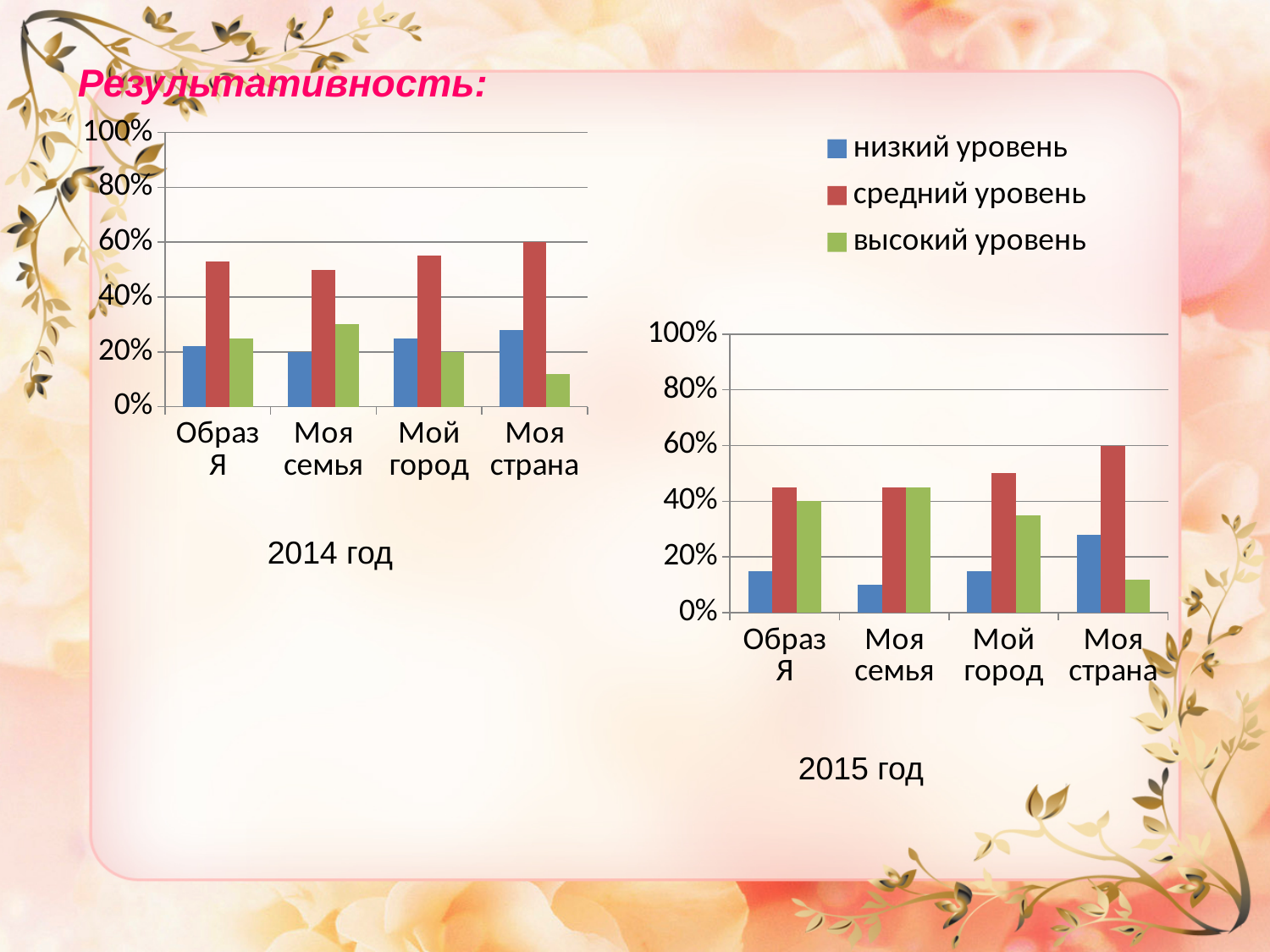
In the 2015 год chart, is the средний уровень value for Мой город greater or less than 40%? greater How many series does the legend list? 3 In the 2015 год chart, which category has the highest низкий уровень bar? Моя страна In the 2015 год chart, which is larger for Моя страна: the низкий уровень bar or the высокий уровень bar? низкий уровень In the 2014 год chart, is the средний уровень value for Образ Я greater or less than 40%? greater In the 2014 год chart, which category has the highest средний уровень bar? Моя страна Which legend entry is shown in green? высокий уровень What kind of chart is the 2014 год chart? bar chart In the 2015 год chart, which category has the lowest высокий уровень bar? Моя страна How many categories are shown on the x axis of the 2015 год chart? 4 In the 2014 год chart, which is larger for Моя семья: the средний уровень bar or the высокий уровень bar? средний уровень In the 2015 год chart, is the низкий уровень value for Моя семья greater or less than 20%? less